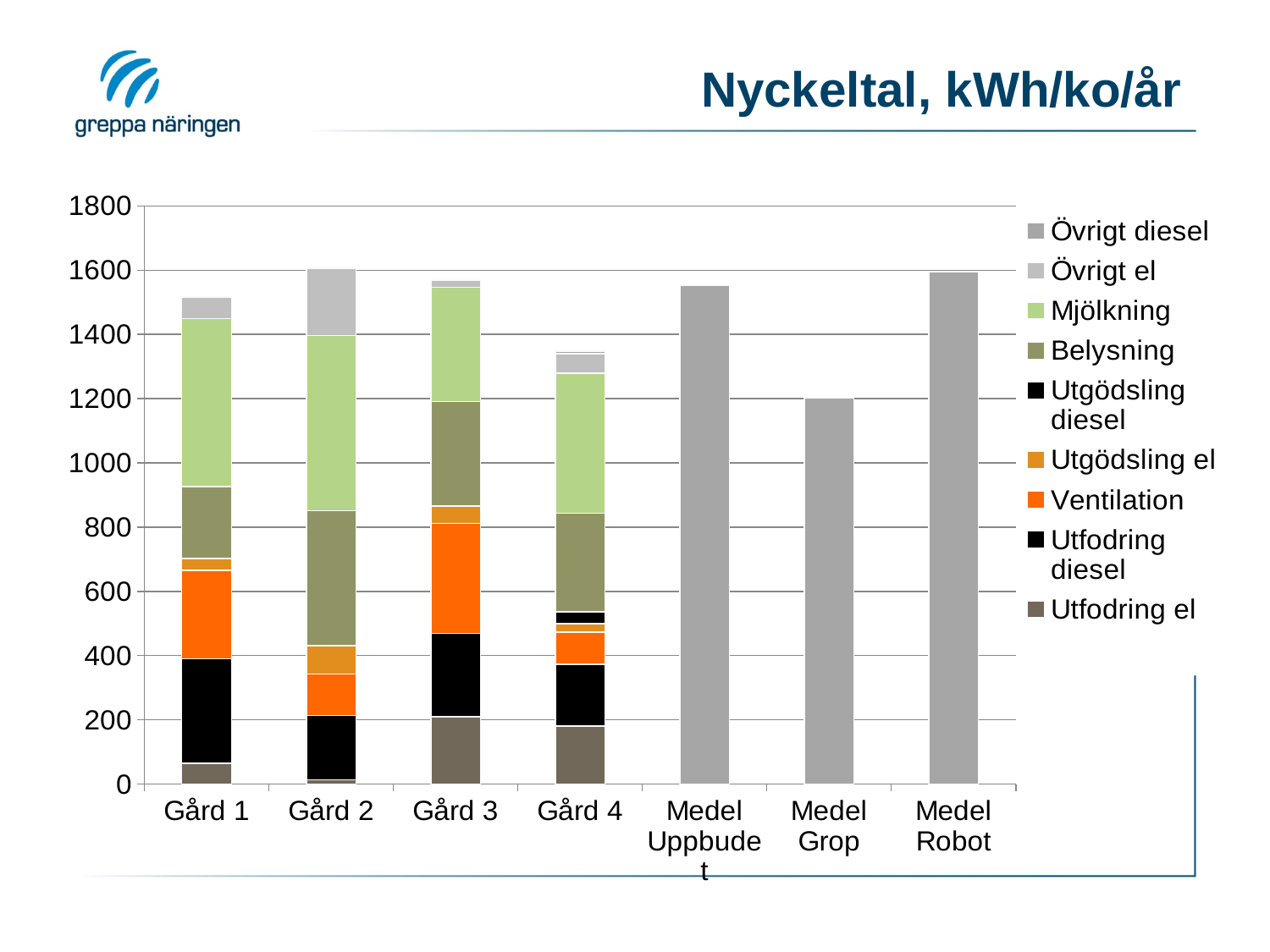
Which category has the lowest total bar in the chart? Medel Grop How many categories are shown along the x axis of the chart? 7 Which bar is taller, Gård 1 or Gård 4? Gård 1 Which bar is taller, Medel Grop or Medel Robot? Medel Robot Is the value for Medel Robot greater or less than 1400? greater Which legend entry is shown in orange in the chart? Ventilation How many series does the chart legend list? 9 What kind of chart is shown on the slide? Stacked bar chart Is the total for Gård 4 greater or less than 1400? less What is the title of the chart on the slide? Nyckeltal, kWh/ko/år Is the total for Gård 1 greater or less than 1400? greater